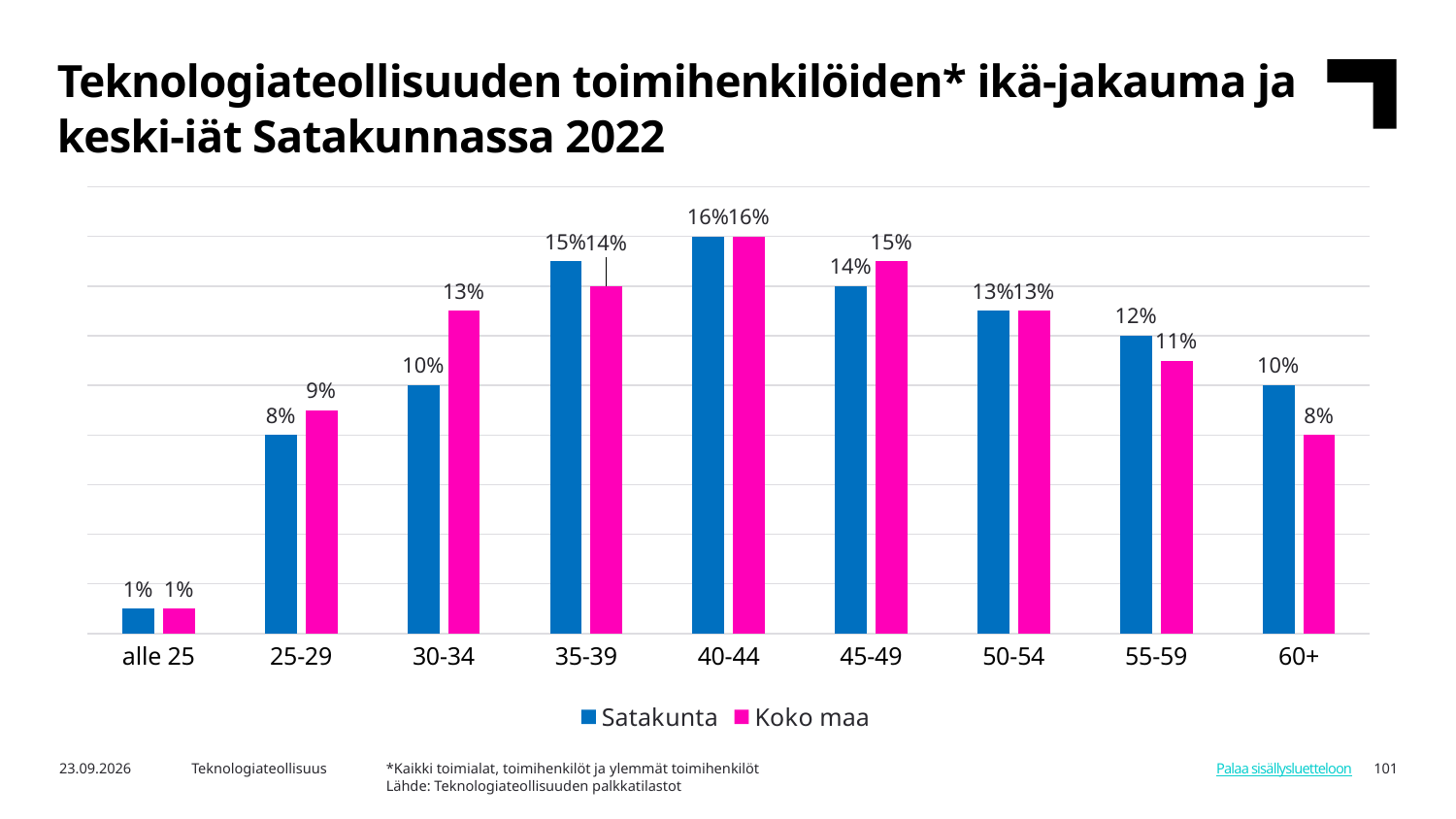
Which age group has the lowest Koko maa value? alle 25 What is the Koko maa value for the 60+ age group? 8% Which is larger for the 45-49 age group, Satakunta or Koko maa? Koko maa Which age group has the highest Satakunta value? 40-44 How many age groups are shown on the x axis? 9 What kind of chart is shown on the slide? Bar chart How many series does the legend list? 2 Which is larger for the 60+ age group, Satakunta or Koko maa? Satakunta What is the difference between the Satakunta values for 40-44 and 25-29? 8% What is the Satakunta value for the 35-39 age group? 15% What is the Koko maa value for the 30-34 age group? 13% What is the difference between the Satakunta and Koko maa values for the 30-34 age group? 3%